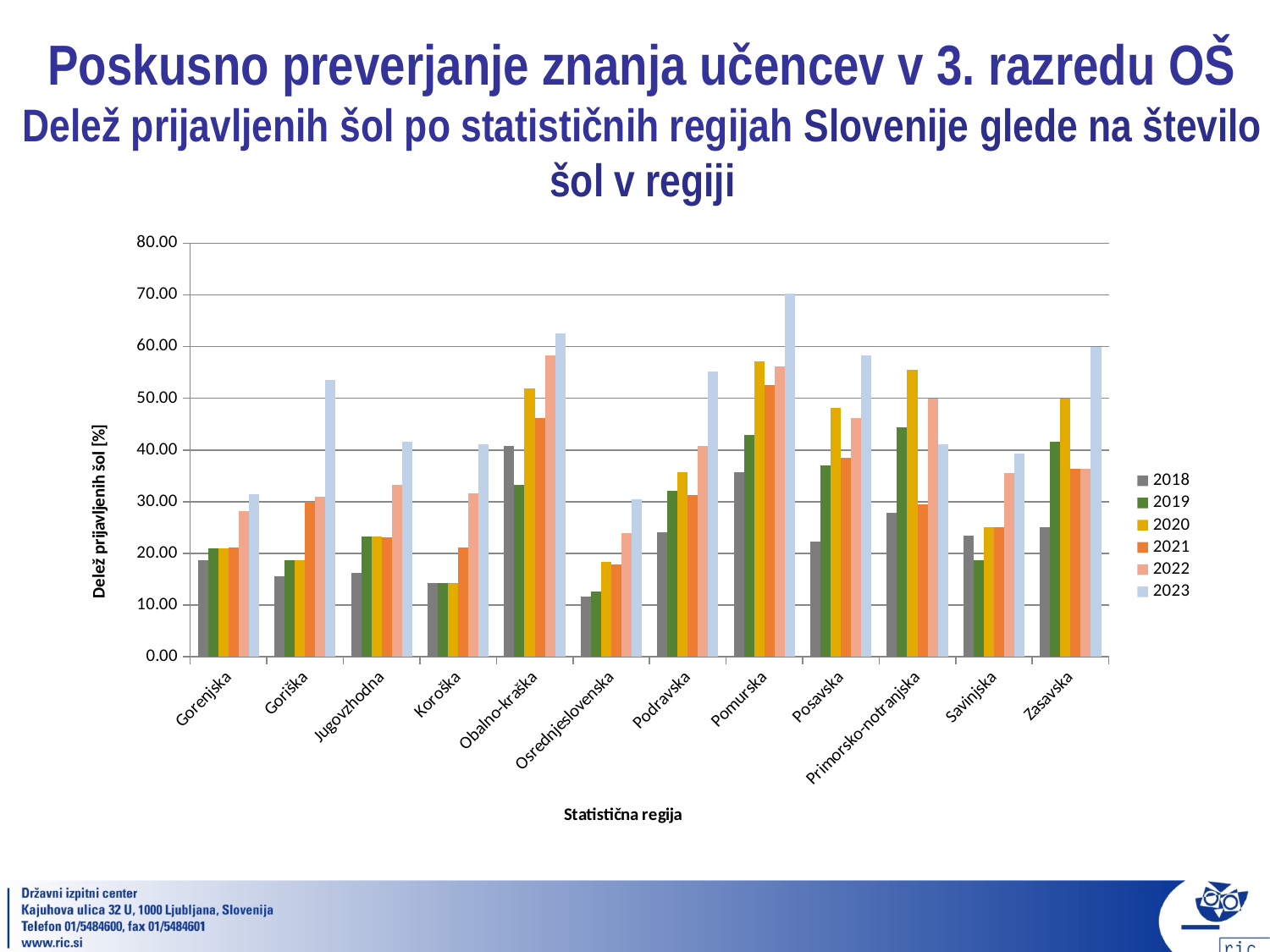
Which region has the lowest value for 2018? Osrednjeslovenska Is the value for Pomurska in 2023 greater or less than 60? greater For Primorsko-notranjska, which is larger: the 2020 value or the 2023 value? 2020 Is the value for Goriška in 2023 greater or less than 50? greater Which region has the highest value for 2023? Pomurska How many statistical regions are shown on the x axis? 12 Which region has the highest value for 2018? Obalno-kraška What is the title of the x axis? Statistična regija What kind of chart is shown on the slide? bar chart Is the value for Osrednjeslovenska in 2018 greater or less than 20? less Which is larger for 2023: Obalno-kraška or Gorenjska? Obalno-kraška How many series does the legend list? 6